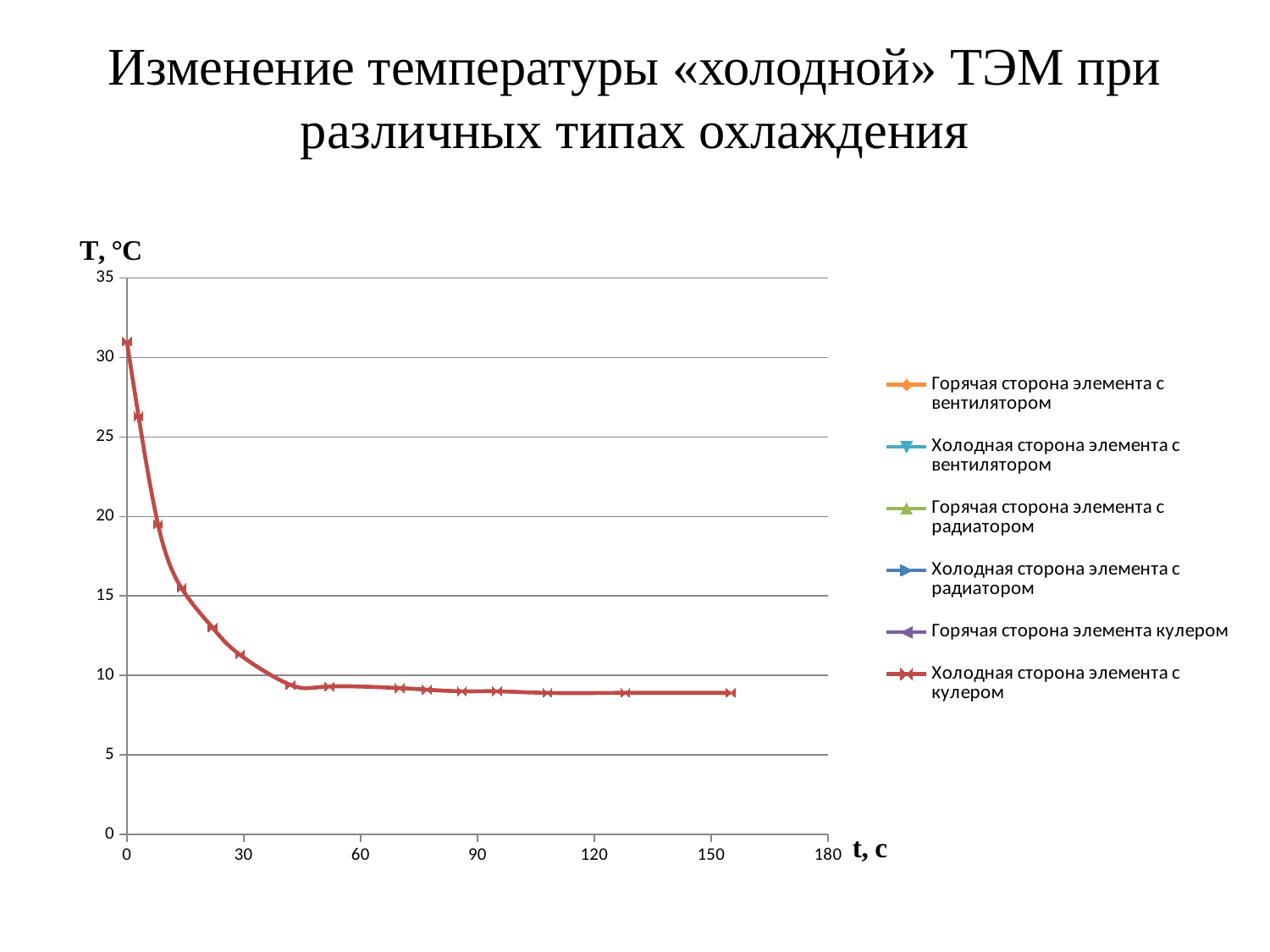
What is the label of the vertical axis? T, °C How many series does the legend list? 6 Is the value of the plotted series at t = 150 greater or less than 15? less Which legend entry corresponds to the red line plotted on the chart? Холодная сторона элемента с кулером Is the value of the plotted series at t = 0 greater or less than 25? greater Does the plotted temperature rise or fall as time increases along the x axis? fall What kind of chart is shown on the slide? line chart Which is larger: the plotted value at t = 0 or the plotted value at t = 90? t = 0 Is the value of the plotted series at t = 30 greater or less than 5? greater